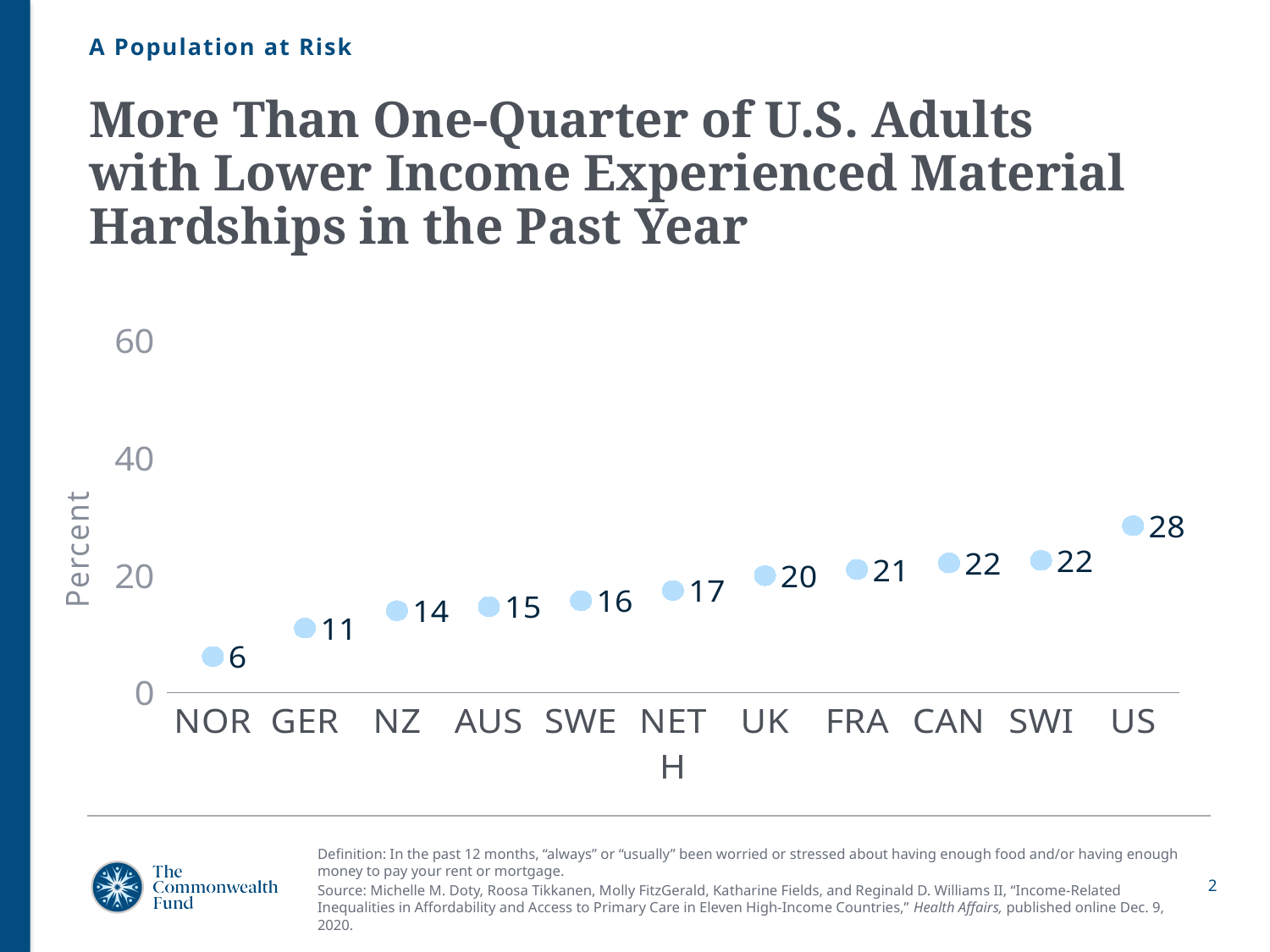
Which country has the highest value? US What is the value for NOR? 6 Is the value for the US greater or less than 20? greater What is the value for the US? 28 What is the difference between the values for the UK and GER? 9 Do the values rise or fall from left to right along the x axis? Rise What is the value for NETH? 17 What kind of chart is shown on the slide? Scatter (dot) chart Which country has the lowest value? NOR Which has a larger value, FRA or AUS? FRA How many countries are plotted on the chart? 11 What is the difference between the values for the US and NOR? 22